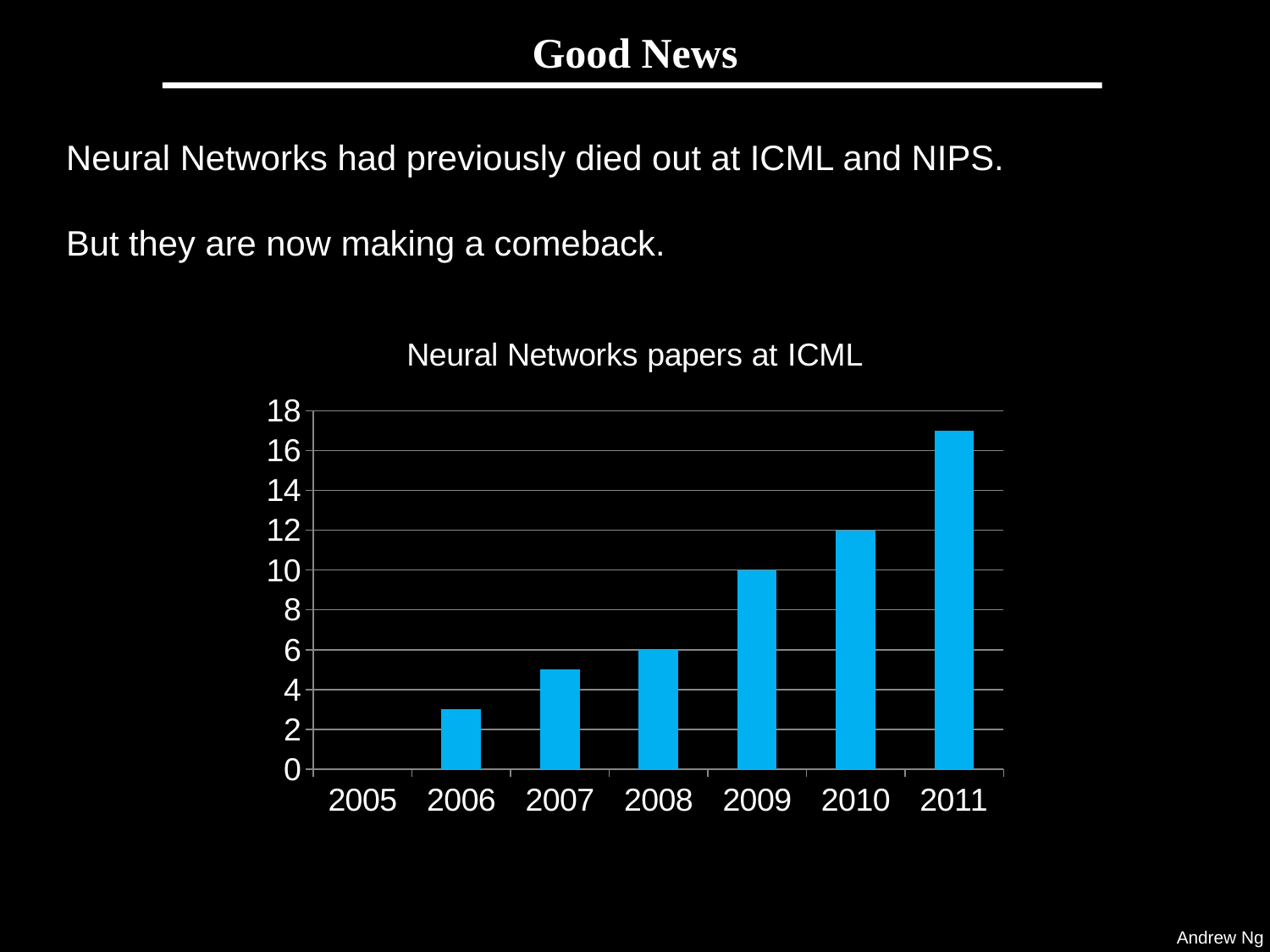
Is the value for 2006 greater or less than 4? less How many Neural Networks papers at ICML are shown for 2008? 6 Which year has the lowest number of Neural Networks papers at ICML? 2005 What is the title of the chart? Neural Networks papers at ICML Which year has the highest number of Neural Networks papers at ICML? 2011 What kind of chart is shown on the slide? Bar chart Do the values rise or fall from 2005 to 2011? Rise What is the difference between the values for 2010 and 2008? 6 How many Neural Networks papers at ICML are shown for 2010? 12 How many Neural Networks papers at ICML are shown for 2009? 10 How many years are shown on the x axis of the chart? 7 Is the value for 2011 greater or less than 16? greater